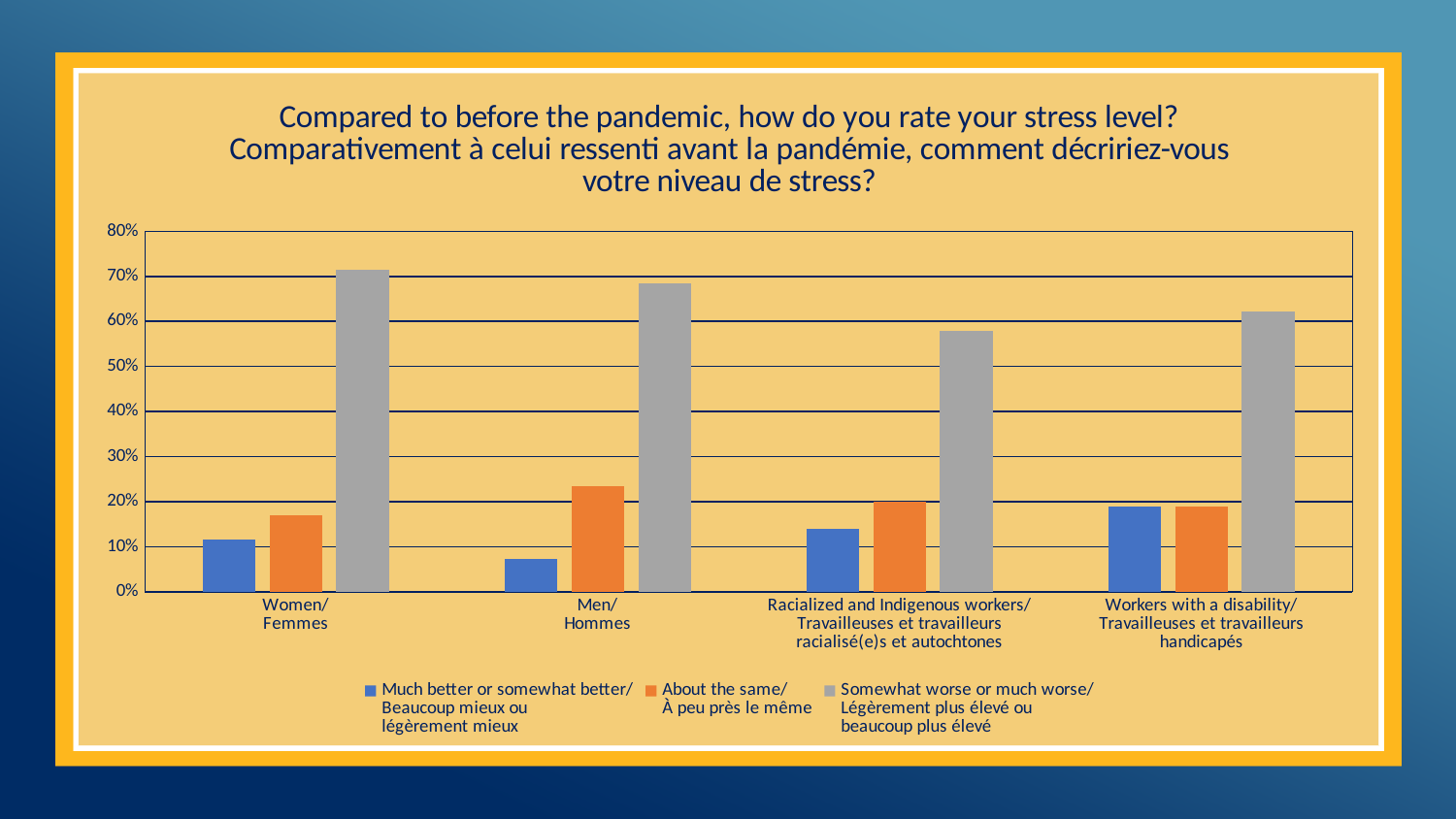
Which group has the lowest value for "Somewhat worse or much worse"? Racialized and Indigenous workers What kind of chart is shown on the slide? bar chart What colour represents the "About the same" series in the legend? orange Which group has the highest value for "Somewhat worse or much worse"? Women/Femmes Is the "Somewhat worse or much worse" value for Men/Hommes greater or less than 70%? less Is the "Somewhat worse or much worse" value for Racialized and Indigenous workers greater or less than 60%? less Which is larger: the "About the same" value for Men/Hommes or for Women/Femmes? Men/Hommes Is the "Much better or somewhat better" value for Men/Hommes greater or less than 10%? less How many series does the legend list? 3 Which group has the lowest value for "Much better or somewhat better"? Men/Hommes How many groups of workers are shown along the x axis? 4